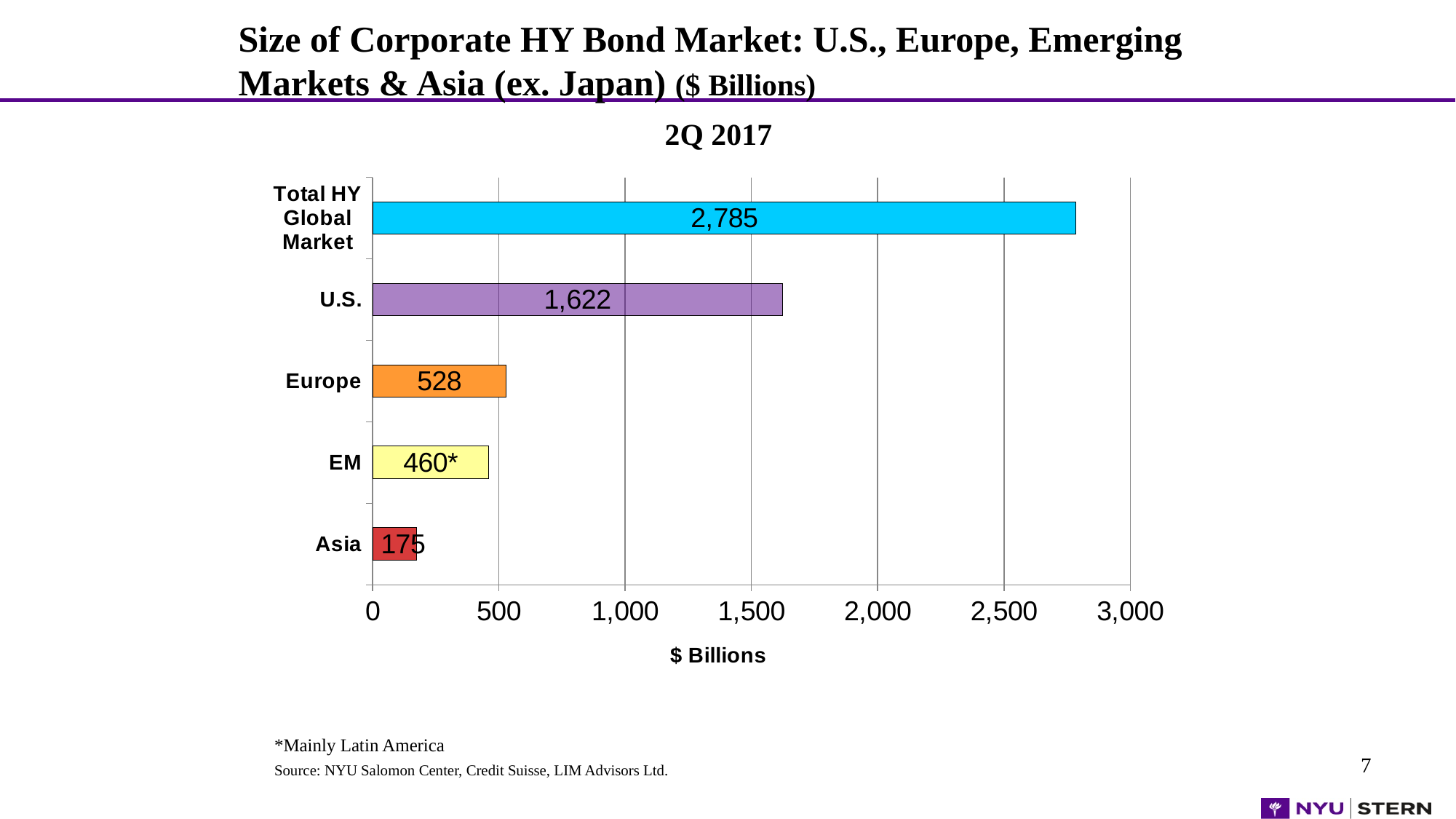
What is the value for the Total HY Global Market bar? 2,785 What kind of chart is shown on the slide? Bar chart Which is larger, the value for Europe or the value for EM? Europe What is the value shown for EM? 460* What is the value for the U.S. bar? 1,622 What is the value for Europe? 528 What is the title shown above the chart? 2Q 2017 What is the difference between the U.S. value and the Europe value? 1,094 Which category has the largest bar? Total HY Global Market What is the value for Asia? 175 Which category has the smallest bar? Asia How many bars are plotted in the chart? 5